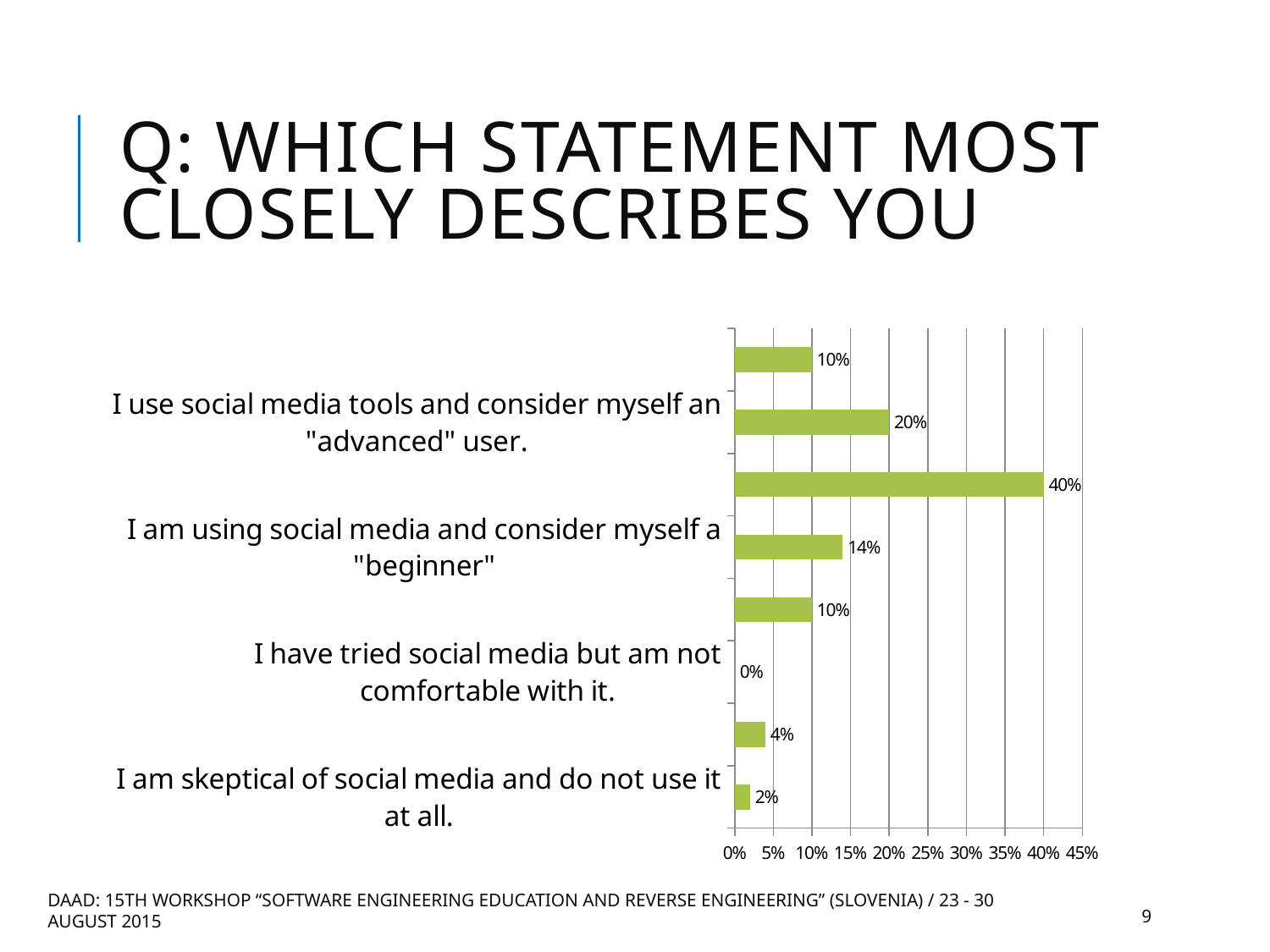
What colour are the bars in the chart? green What is the difference between the longest bar (40%) and the second bar from the top (20%)? 20% What is the lowest value shown by any bar in the chart? 0% What is the value of the topmost bar in the chart? 10% What is the value of the bottom bar in the chart? 2% What is the highest value shown by any bar in the chart? 40% How many bars are plotted in the chart? 8 What is the maximum value shown on the horizontal axis of the chart? 45% What kind of chart is shown on the slide? bar chart Which is larger: the bar labelled 14% or the bar labelled 4%? 14% Is the longest bar in the chart greater or less than 35%? greater What is the value of the second bar from the top in the chart? 20%